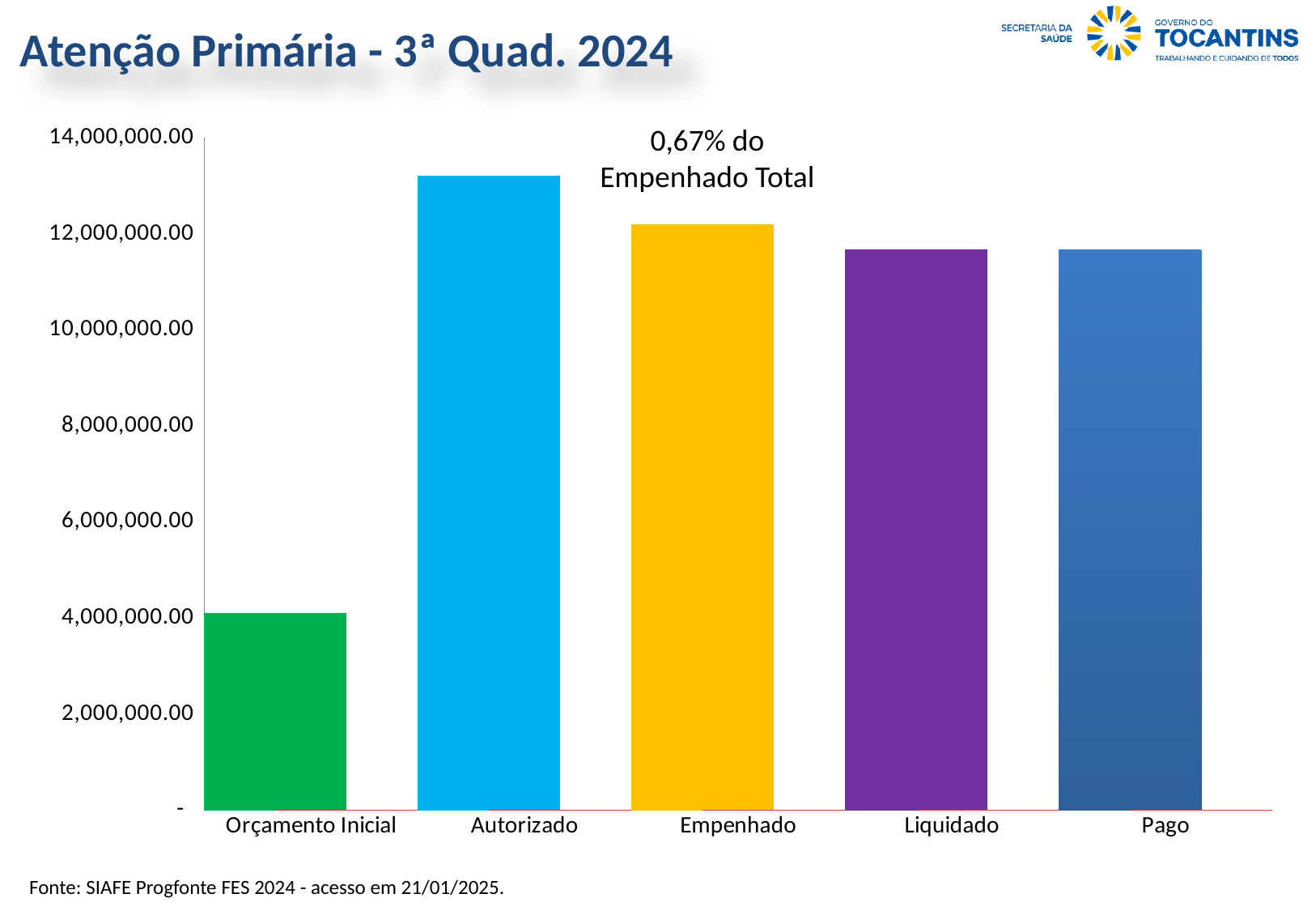
Is the value for Liquidado greater or less than 12,000,000.00? less Is the value for Pago greater or less than 10,000,000.00? greater Which is larger, the value for Autorizado or the value for Empenhado? Autorizado Which category has the highest value in the chart? Autorizado Is the value for Autorizado greater or less than 12,000,000.00? greater Which is larger, the value for Orçamento Inicial or the value for Pago? Pago What is the title of the slide containing the chart? Atenção Primária - 3ª Quad. 2024 What kind of chart is shown on the slide? bar chart What percentage annotation is written above the Empenhado bar? 0,67% do Empenhado Total Which category has the lowest value in the chart? Orçamento Inicial How many categories are shown on the x axis of the chart? 5